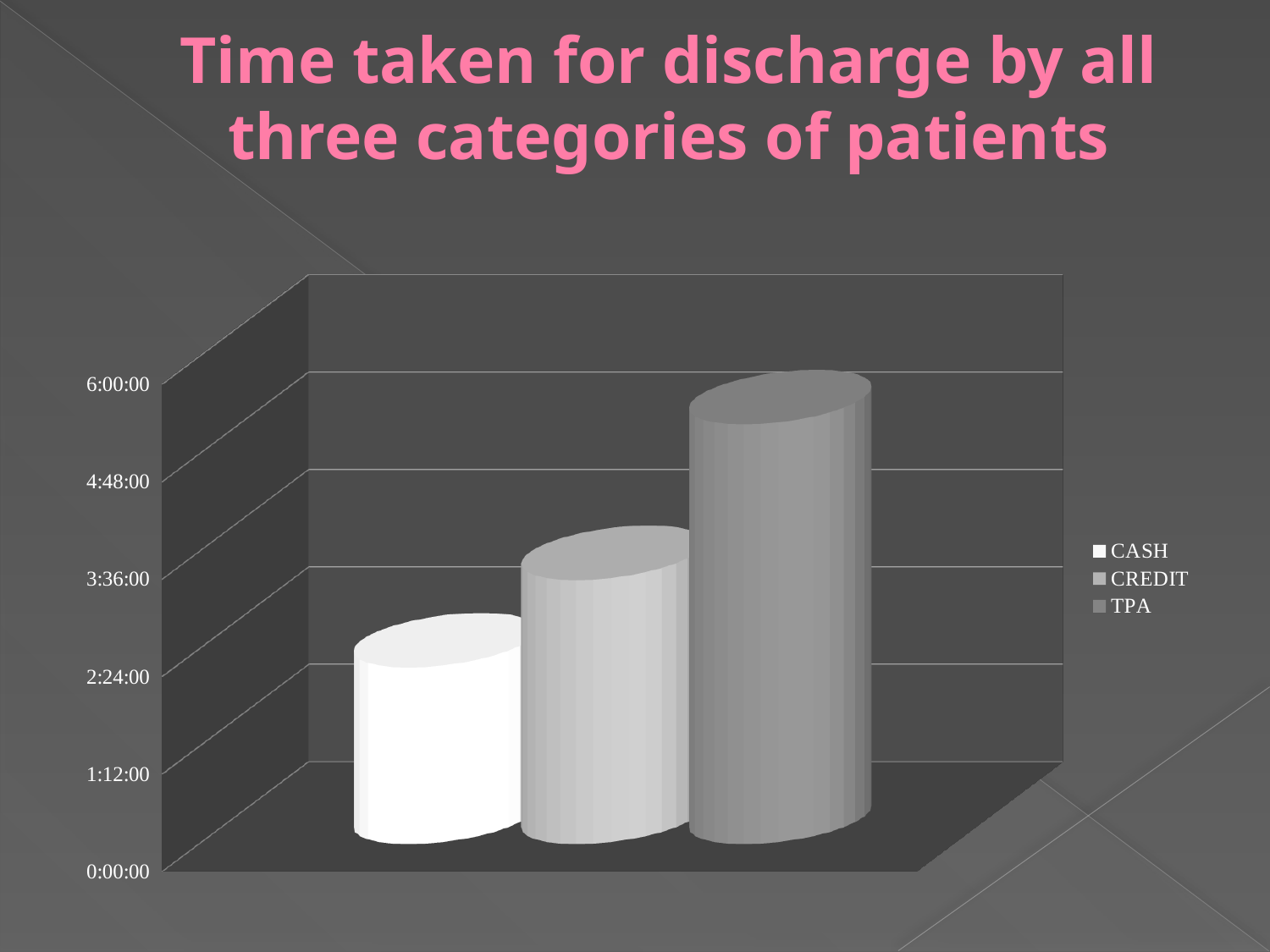
What kind of chart is shown on the slide? bar chart Is the value for TPA greater or less than 4:48:00? greater Is the value for CASH greater or less than 3:36:00? less Do the values rise or fall from left to right across the bars? rise Which category has the highest discharge time? TPA Which series are listed in the legend? CASH, CREDIT, TPA Which is larger, the value for CREDIT or the value for CASH? CREDIT Which is larger, the value for TPA or the value for CASH? TPA How many series does the legend list? 3 How many bars are plotted in the chart? 3 Which category has the lowest discharge time? CASH What is the title of the chart? Time taken for discharge by all three categories of patients